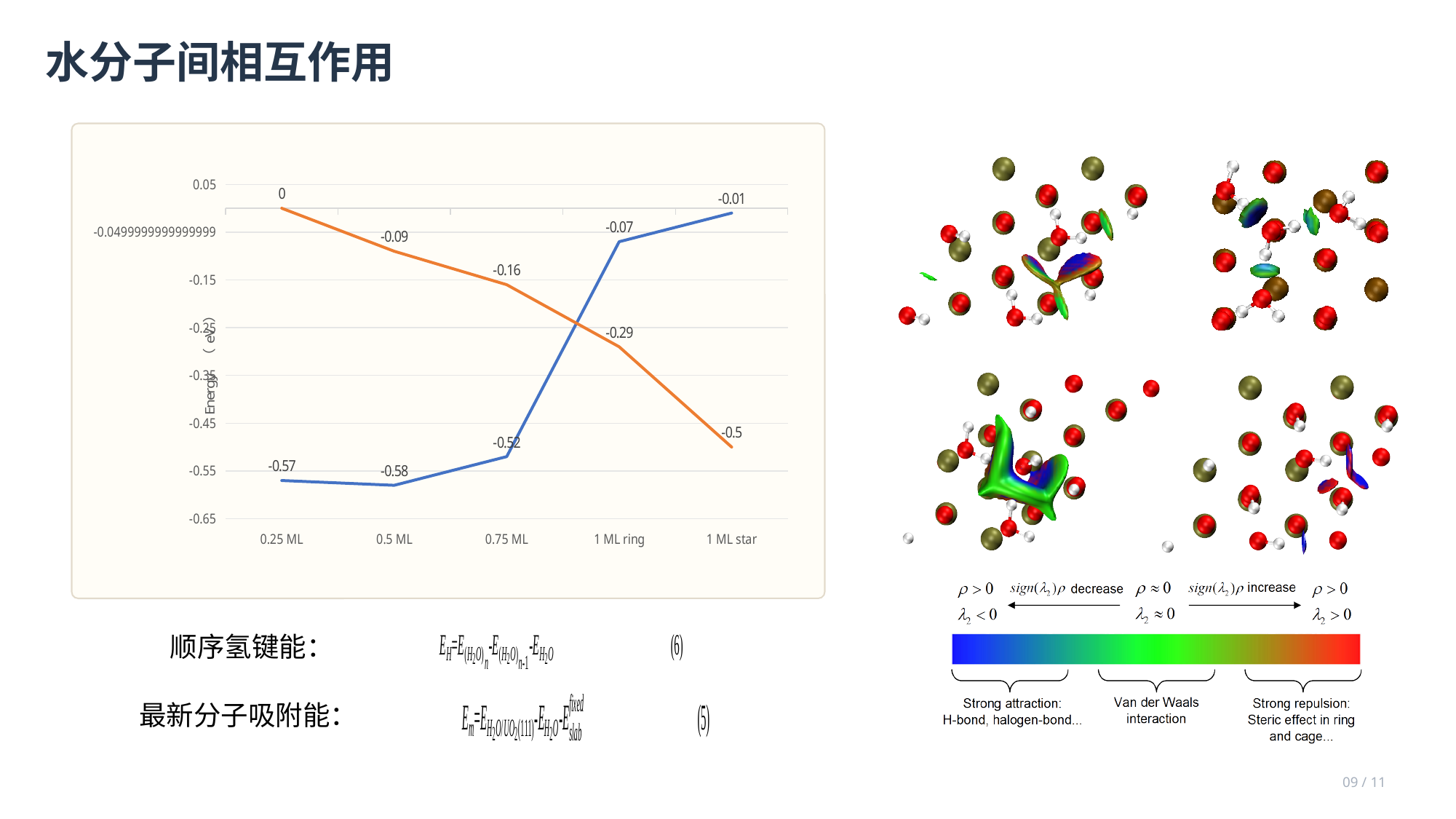
What is the difference between the blue line's values at 1 ML ring and 0.75 ML? 0.45 What is the value of the blue line at 0.75 ML? -0.52 How many categories are shown on the x axis? 5 What type of chart is shown on the slide? line chart At 0.25 ML, which line has the larger value, the orange or the blue? orange What is the value of the orange line at 1 ML star? -0.5 What is the value of the blue line at 1 ML ring? -0.07 At which category does the blue line reach its lowest value? 0.5 ML At which category does the orange line reach its highest value? 0.25 ML Does the orange line rise or fall from 0.25 ML to 1 ML star? fall What is the value of the orange line at 0.5 ML? -0.09 What is the label of the y axis? Energy (eV)